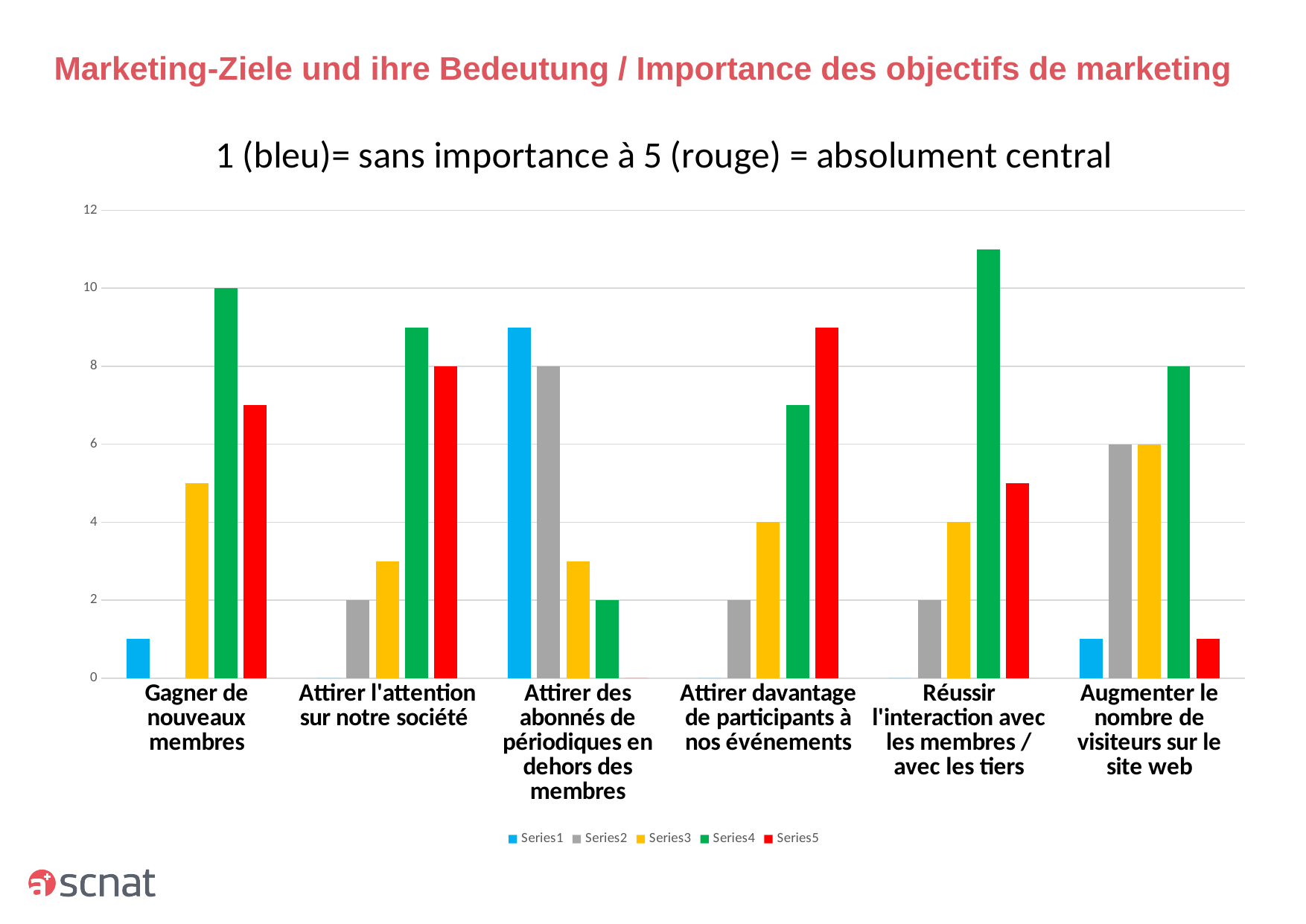
What is the value of Series4 for 'Augmenter le nombre de visiteurs sur le site web'? 8 What kind of chart is shown on the slide? bar chart Is the value of Series4 for 'Réussir l'interaction avec les membres / avec les tiers' greater or less than 10? greater How many series does the legend list? 5 What is the difference between the Series4 value for 'Gagner de nouveaux membres' and the Series4 value for 'Augmenter le nombre de visiteurs sur le site web'? 2 What is the value of Series3 for 'Attirer davantage de participants à nos événements'? 4 How many categories are shown along the x axis of the chart? 6 Which category has the highest Series4 value? Réussir l'interaction avec les membres / avec les tiers What is the value of Series2 for 'Attirer des abonnés de périodiques en dehors des membres'? 8 What is the value of Series5 for 'Attirer l'attention sur notre société'? 8 For 'Attirer des abonnés de périodiques en dehors des membres', which is larger: Series1 or Series2? Series1 What is the value of Series4 for 'Gagner de nouveaux membres'? 10